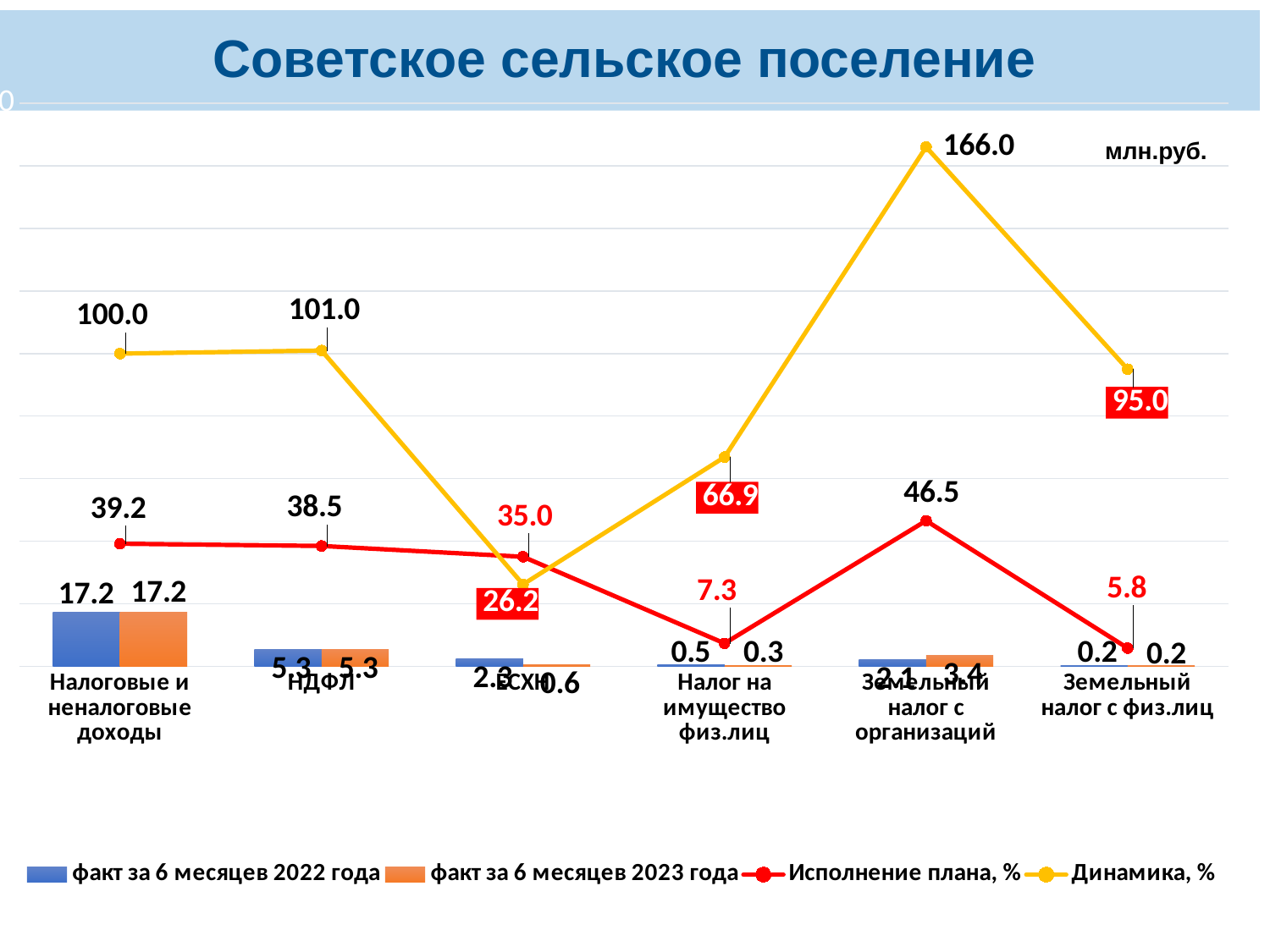
How many series does the legend list? 4 What kind of chart is shown on the slide? A combined bar and line chart What unit is indicated in the top right corner of the chart? млн.руб. Which category has the highest value of Исполнение плана, %? Земельный налог с организаций What is the value of Динамика, % for Земельный налог с организаций? 166.0 Which category has the highest value of Динамика, %? Земельный налог с организаций What is the difference between the Динамика, % values for Земельный налог с организаций and Земельный налог с физ.лиц? 71.0 What is the value of факт за 6 месяцев 2023 года for Налог на имущество физ.лиц? 0.3 For Земельный налог с организаций, which is larger: факт за 6 месяцев 2022 года or факт за 6 месяцев 2023 года? факт за 6 месяцев 2023 года Which category has the lowest value of Динамика, %? ЕСХН What is the value of Исполнение плана, % for НДФЛ? 38.5 How many categories are shown along the x axis? 6